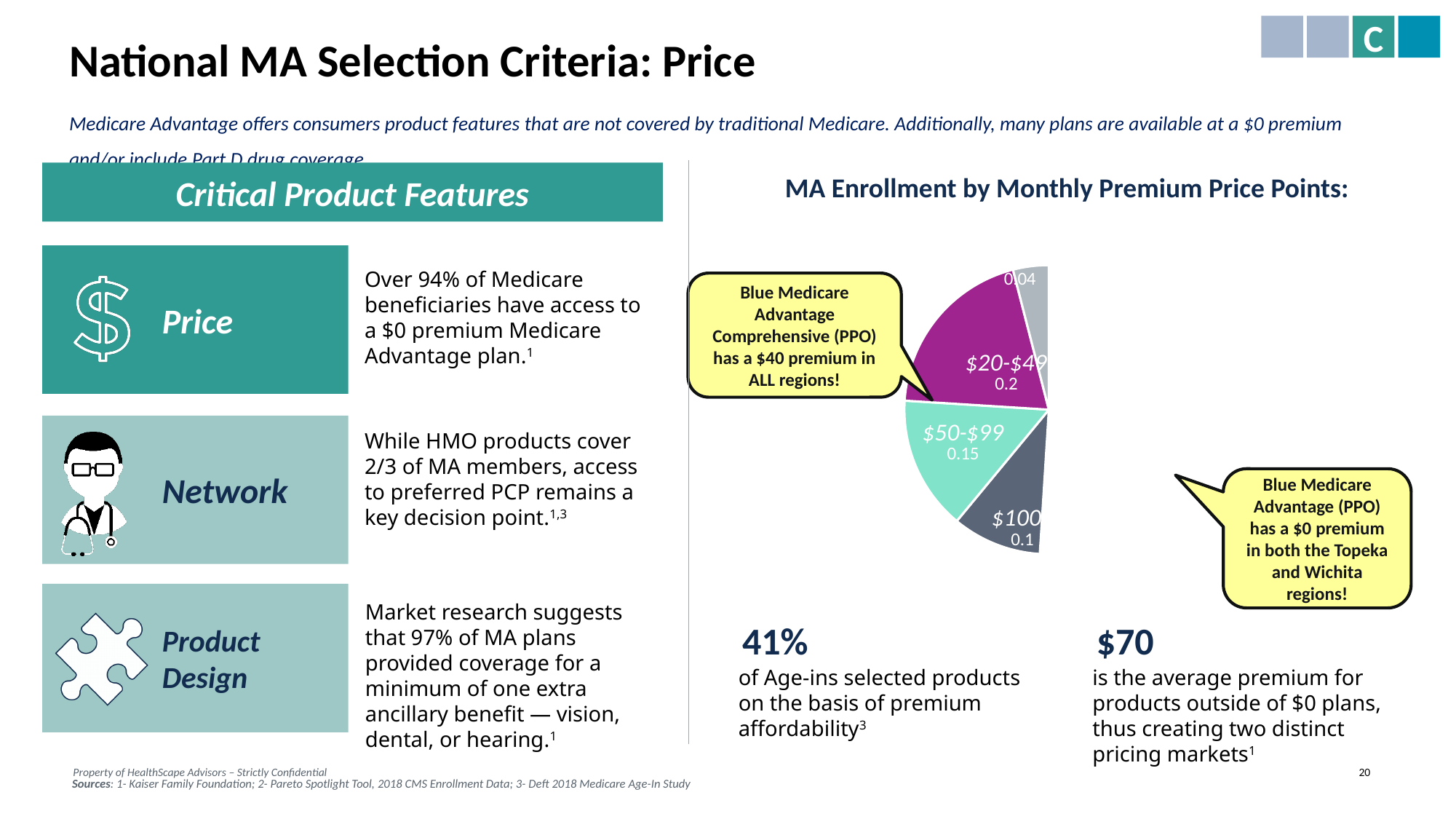
In the MA Enrollment by Monthly Premium Price Points chart, which is larger: the $20-$49 slice or the $50-$99 slice? $20-$49 In the MA Enrollment by Monthly Premium Price Points chart, what is the difference between the $20-$49 value and the $100 value? 0.1 In the MA Enrollment by Monthly Premium Price Points chart, which is larger: the $50-$99 slice or the $100 slice? $50-$99 In the MA Enrollment by Monthly Premium Price Points chart, what value is shown for the $100 slice? 0.1 In the MA Enrollment by Monthly Premium Price Points chart, what is the value of the small grey slice at the top? 0.04 In the MA Enrollment by Monthly Premium Price Points chart, what value is shown for the $50-$99 slice? 0.15 What is the title of the chart on the right side of the slide? MA Enrollment by Monthly Premium Price Points: In the MA Enrollment by Monthly Premium Price Points chart, what colour is the $50-$99 slice? Teal (light green) What type of chart is shown under "MA Enrollment by Monthly Premium Price Points"? Pie chart In the MA Enrollment by Monthly Premium Price Points chart, what value is shown for the $20-$49 slice? 0.2 In the MA Enrollment by Monthly Premium Price Points chart, of the $20-$49, $50-$99 and $100 slices, which has the largest value? $20-$49 In the MA Enrollment by Monthly Premium Price Points chart, what is the difference between the $20-$49 value and the $50-$99 value? 0.05